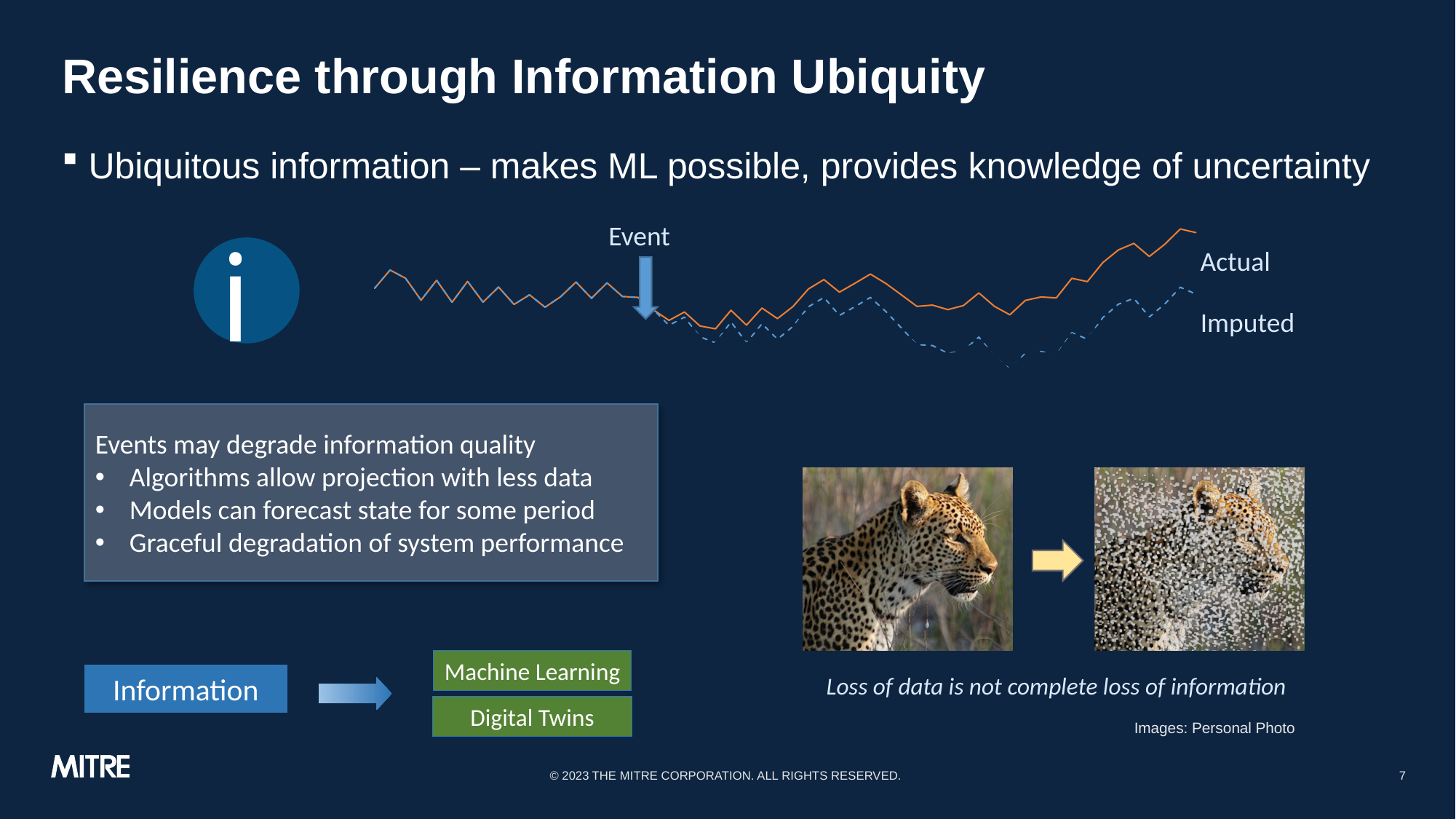
What are the names of the two series in the line chart? Actual and Imputed What kind of chart is shown at the top of the slide next to the information icon? line chart Does the Actual line rise or fall overall from the Event marker to the right end of the chart? rise How many series are plotted in the line chart? 2 What label marks the point in the line chart where the Actual and Imputed lines begin to diverge? Event Before the Event marker, do the Actual and Imputed lines overlap or diverge? overlap At the right end of the line chart, which series is higher, Actual or Imputed? Actual